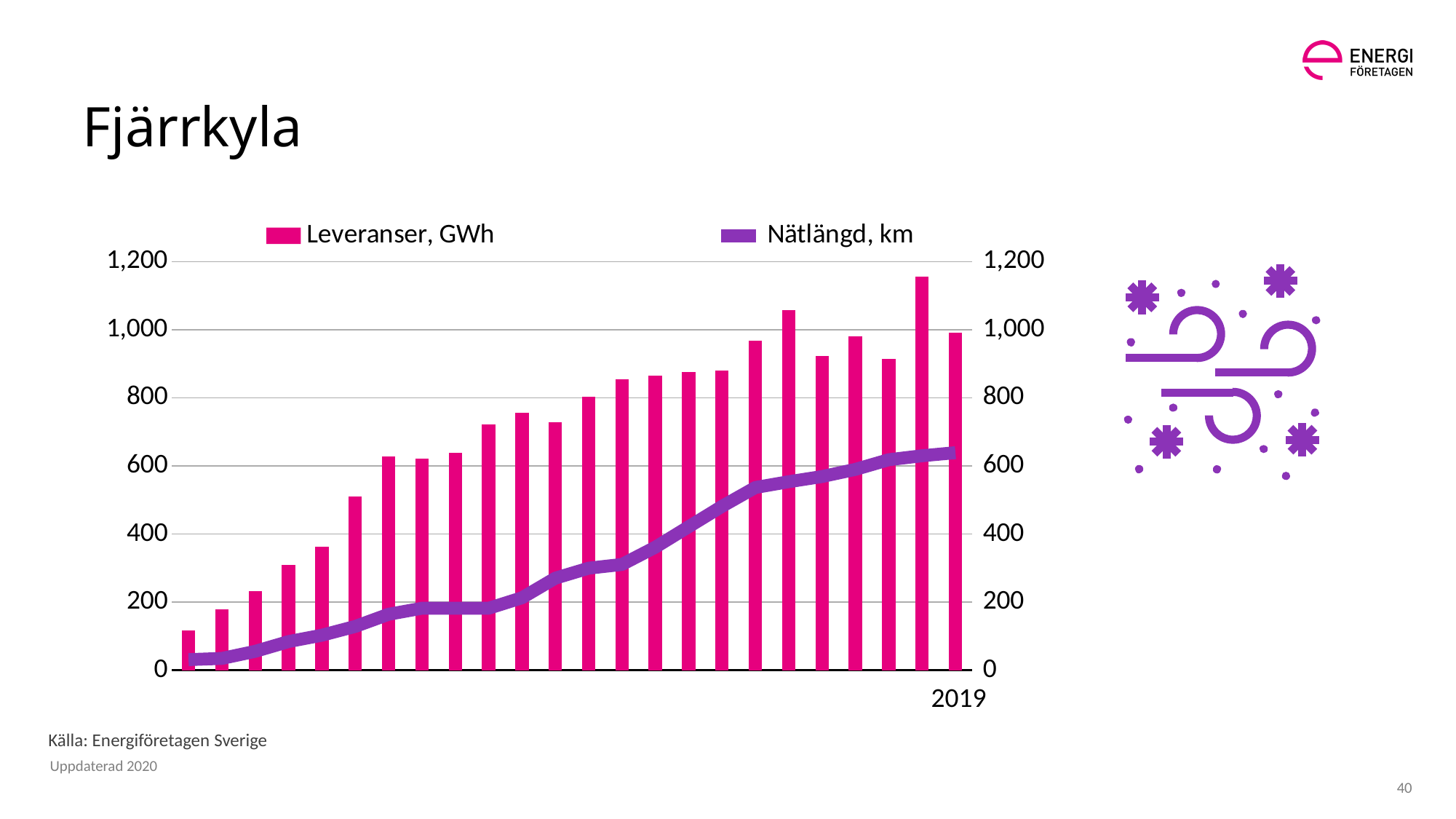
In 2019, which is larger on the chart's scale: Leveranser, GWh or Nätlängd, km? Leveranser, GWh Is the 2019 bar the highest Leveranser, GWh bar in the chart? No Does the Nätlängd, km line rise or fall along the x axis? rise What are the two series named in the legend? Leveranser, GWh and Nätlängd, km How many series does the legend list? 2 Which series is drawn as bars? Leveranser, GWh What kind of chart is shown on the slide? A bar chart combined with a line How many bars are plotted for Leveranser, GWh? 24 Is the leftmost Leveranser, GWh bar greater or less than 200? less Is the value for Nätlängd, km in 2019 greater or less than 800? less Is the value for Leveranser, GWh in 2019 greater or less than 800? greater